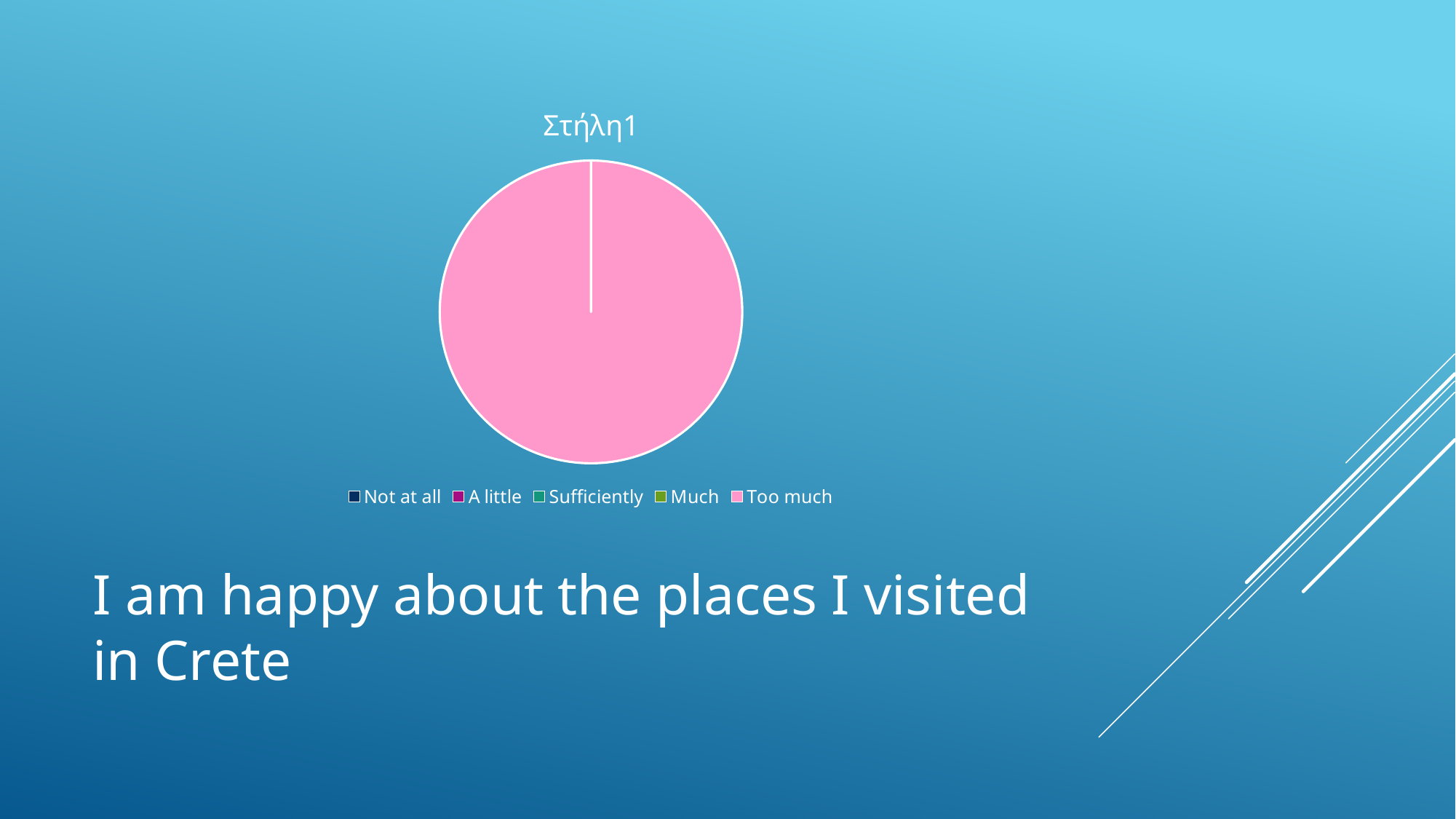
What colour is the slice for Too much in the pie chart? pink What kind of chart is shown on the slide? pie chart Which category fills the entire pie chart? Too much How many categories does the legend of the pie chart list? 5 What is the title shown above the pie chart? Στήλη1 Which category accounts for the largest share of the pie chart? Too much Which of the two categories, Much or Too much, has the larger share of the pie? Too much How many visible slices does the pie chart have? 1 Which of the two categories, Too much or Not at all, has the larger share of the pie? Too much